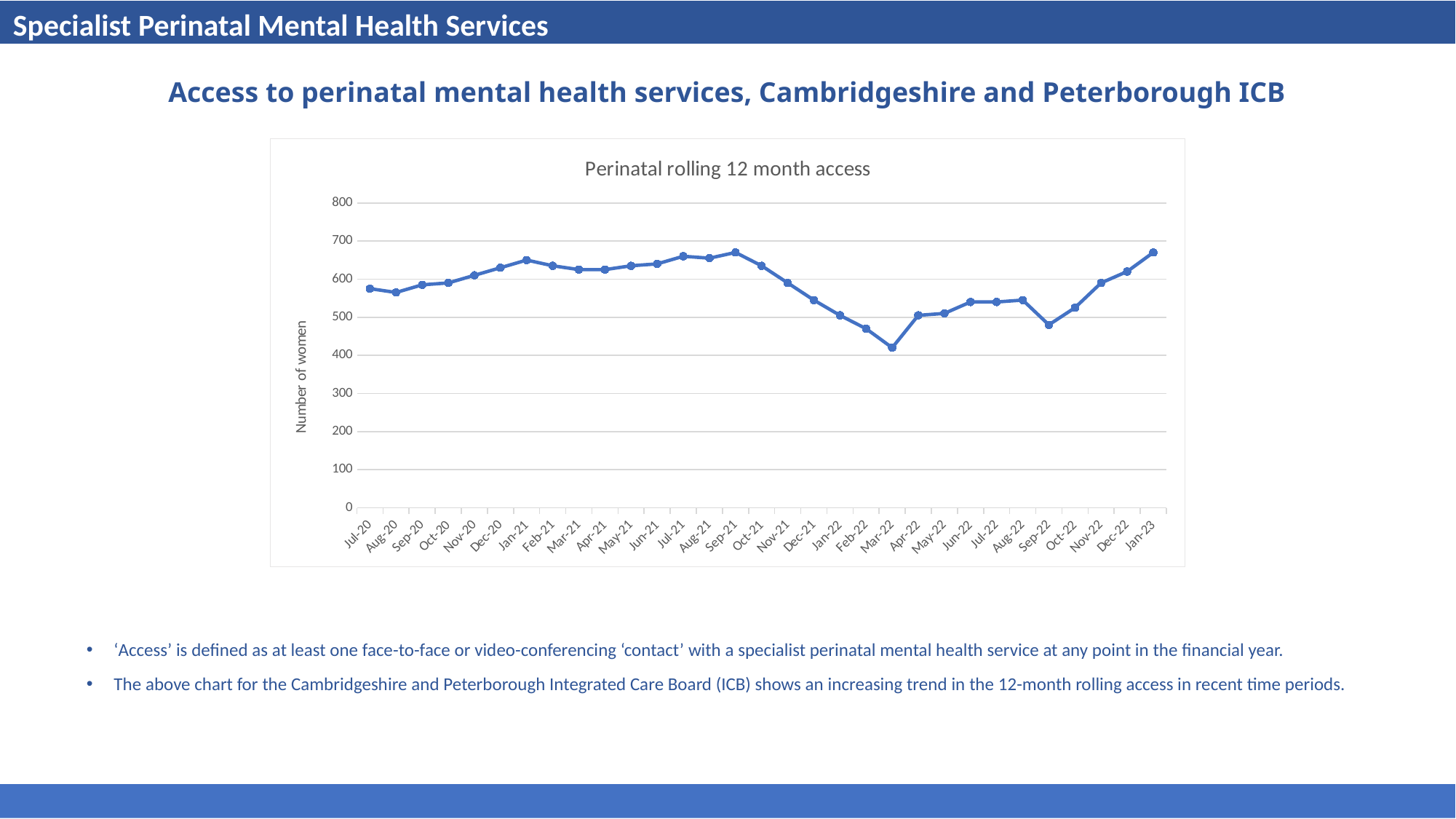
Is the value for Jan-21 greater or less than 600? greater Is the value for Jan-23 greater or less than 600? greater What kind of chart is shown on the slide? Line chart Which month has the lowest value on the chart? Mar-22 What is the title of the chart? Perinatal rolling 12 month access Is the value for Sep-22 greater or less than 500? less What is the label on the vertical axis of the chart? Number of women How many monthly data points are plotted on the chart? 31 Do the values rise or fall between Sep-21 and Mar-22? fall Which is larger, the value for Jul-21 or the value for Sep-22? Jul-21 Do the values rise or fall between Jul-20 and Jan-21? rise